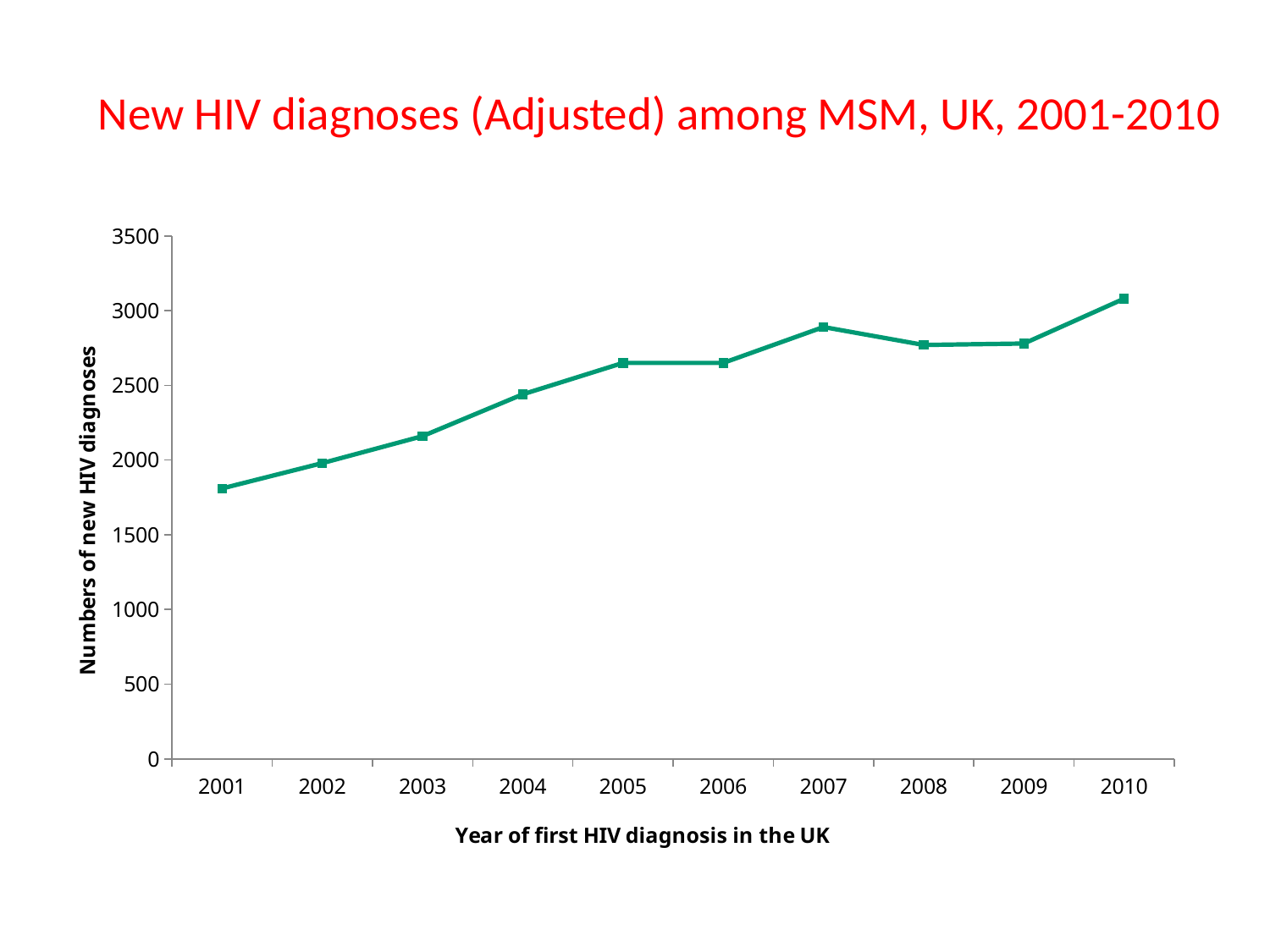
What kind of chart is shown on the slide? line chart Is the value for 2010 greater or less than 3000? greater Is the value for 2001 greater or less than 2000? less Which year has the lowest number of new HIV diagnoses? 2001 Is the value for 2005 greater or less than 2500? greater Which year has a higher number of new HIV diagnoses, 2007 or 2008? 2007 How many years are plotted on the x axis? 10 Do the values generally rise or fall from 2001 to 2010? rise Which year has the highest number of new HIV diagnoses? 2010 What is the label on the y axis of the chart? Numbers of new HIV diagnoses